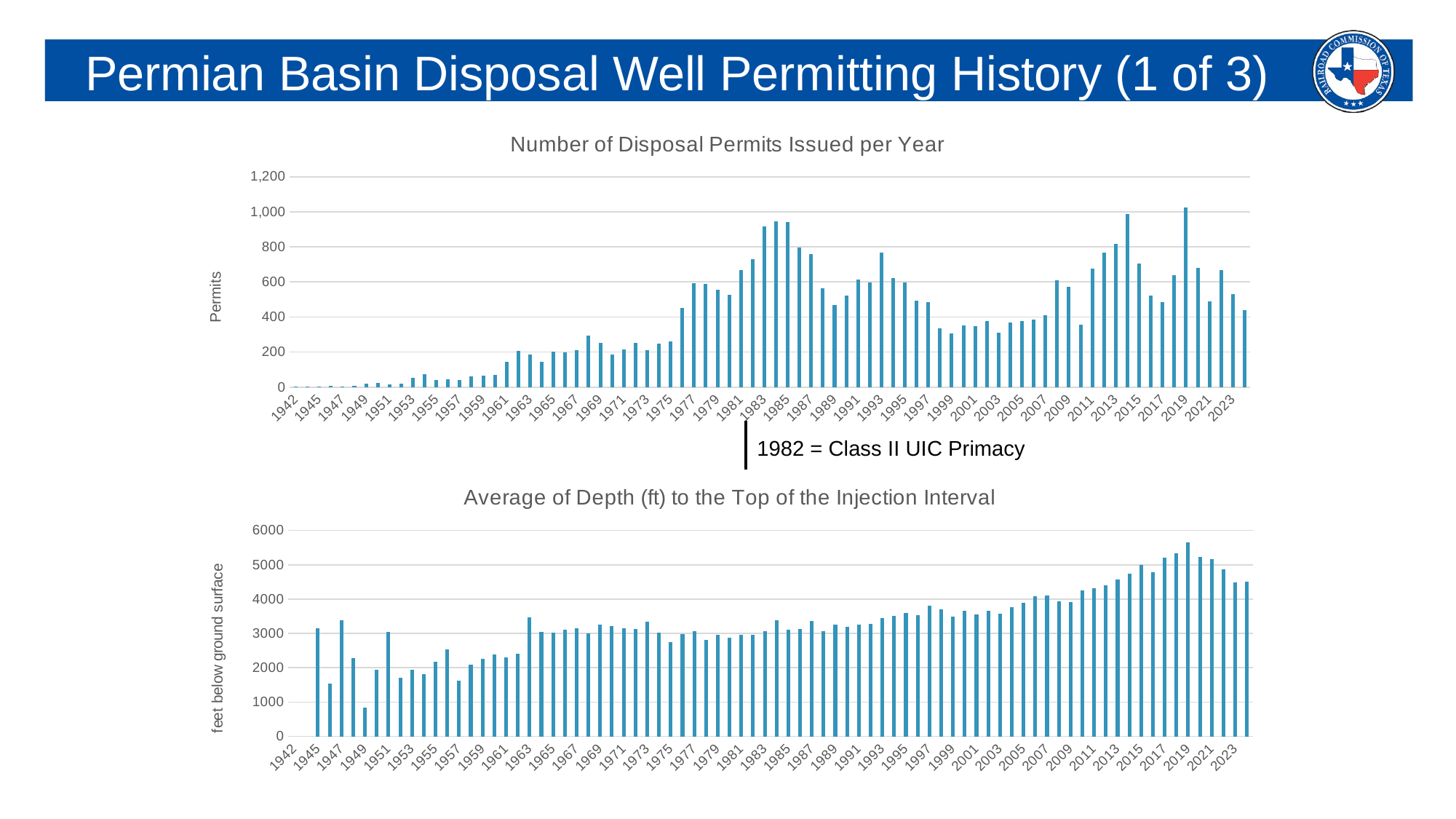
In the 'Average of Depth (ft) to the Top of the Injection Interval' chart, is the value for 1949 greater or less than 1000? less What is the y-axis label of the 'Average of Depth (ft) to the Top of the Injection Interval' chart? feet below ground surface In the 'Number of Disposal Permits Issued per Year' chart, is the value for 2019 greater or less than 1,000? greater In the 'Number of Disposal Permits Issued per Year' chart, is the value for 2000 greater or less than 400? less In the 'Average of Depth (ft) to the Top of the Injection Interval' chart, do the values generally rise or fall from 1995 to 2019? rise In the 'Average of Depth (ft) to the Top of the Injection Interval' chart, which year has the highest average depth? 2019 In the 'Number of Disposal Permits Issued per Year' chart, which year has the highest number of permits? 2019 In the 'Average of Depth (ft) to the Top of the Injection Interval' chart, which is larger, the value for 2019 or the value for 1949? 2019 What kind of chart is the 'Number of Disposal Permits Issued per Year' chart? bar chart